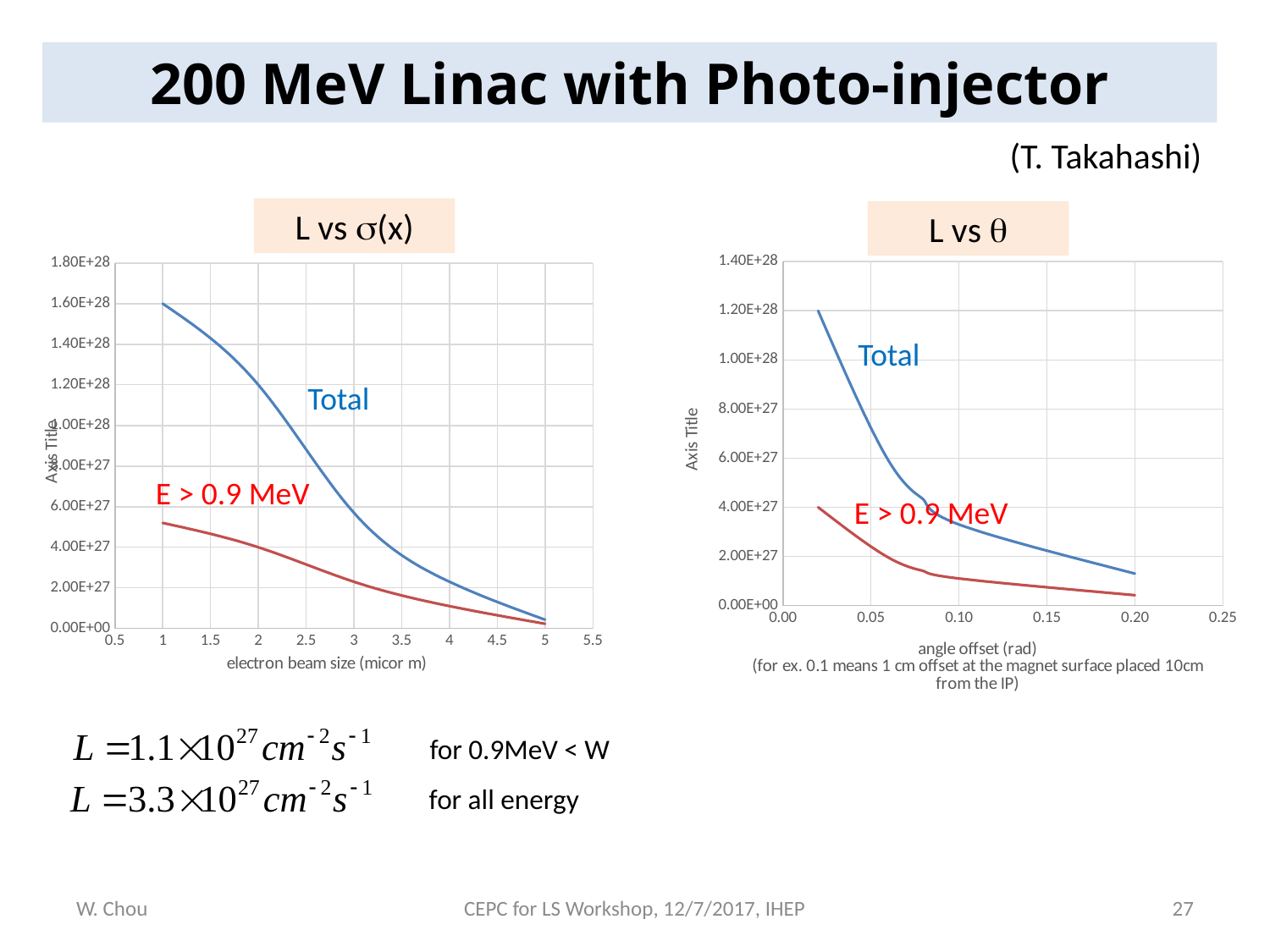
In the 'L vs σ(x)' chart, does the Total curve rise or fall as electron beam size increases? fall In the 'L vs θ' chart, is the Total value at an angle offset of 0.10 greater or less than 6.00E+27? less In the 'L vs σ(x)' chart, what kind of chart is shown? line chart In the 'L vs σ(x)' chart, is the Total value at an electron beam size of 2 greater or less than 1.00E+28? greater In the 'L vs θ' chart, is the E > 0.9 MeV value at an angle offset of 0.20 greater or less than 2.00E+27? less In the 'L vs θ' chart, what kind of chart is shown? line chart In the 'L vs σ(x)' chart, at an electron beam size of 3, which curve is higher: Total or E > 0.9 MeV? Total What is the x-axis title of the 'L vs σ(x)' chart? electron beam size (micor m) In the 'L vs θ' chart, does the E > 0.9 MeV curve rise or fall as angle offset increases? fall In the 'L vs θ' chart, which curve is drawn in blue? Total